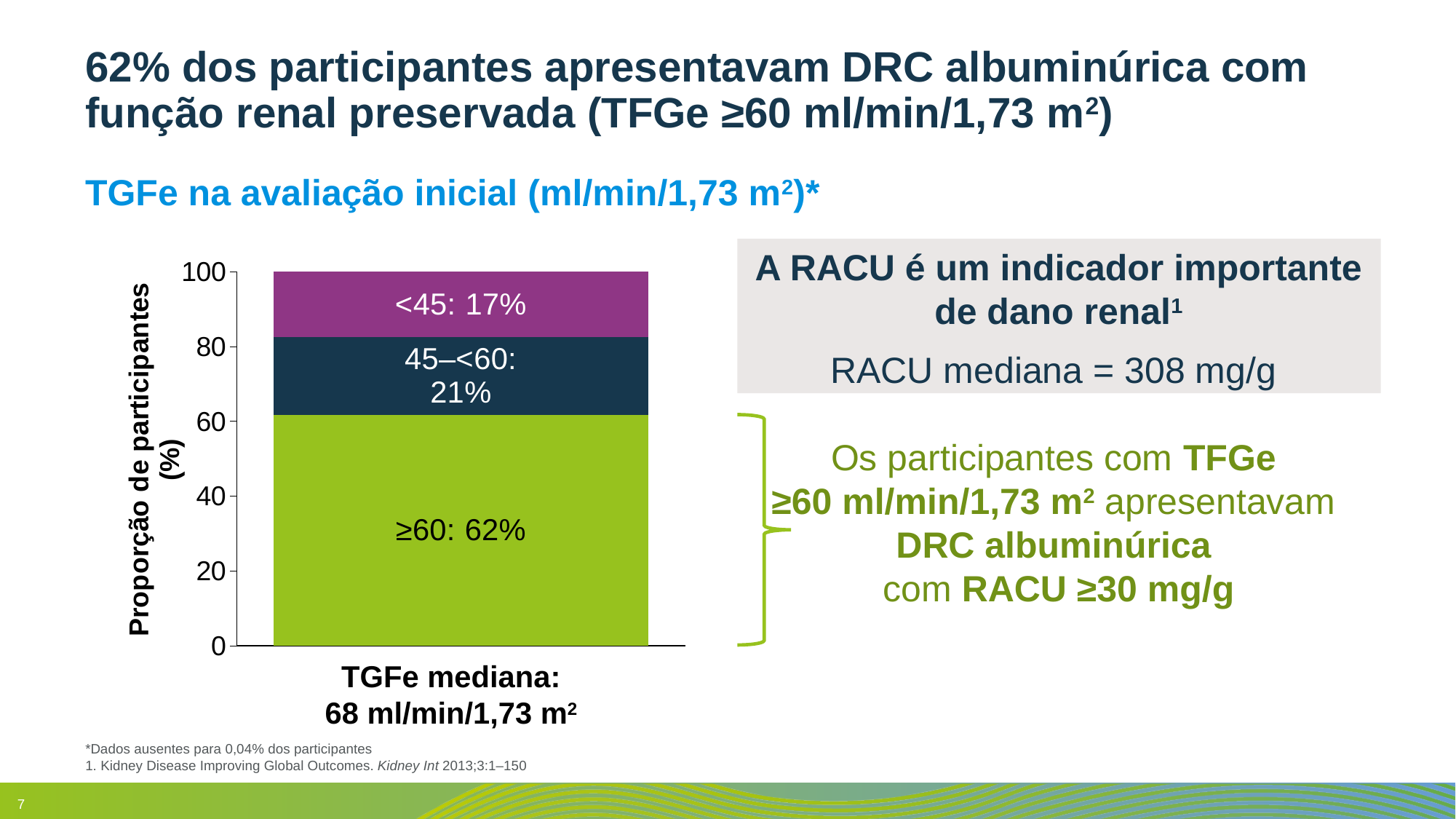
How many TGFe categories are shown in the stacked bar? 3 What median TGFe value is given below the bar? 68 ml/min/1,73 m² What type of chart is shown on the slide? Stacked bar chart What is the label on the y axis of the chart? Proporção de participantes (%) What percentage of participants fell in the 45–<60 TGFe category? 21% What is the total of the three segments in the stacked bar? 100% Which TGFe category has the smallest share of participants? <45 Which TGFe category has the largest share of participants? ≥60 What is the difference in percentage points between the ≥60 category and the 45–<60 category? 41 What percentage of participants had a TGFe of <45 ml/min/1,73 m²? 17% What percentage of participants had a TGFe of ≥60 ml/min/1,73 m²? 62% Which category has a larger share of participants, <45 or 45–<60? 45–<60